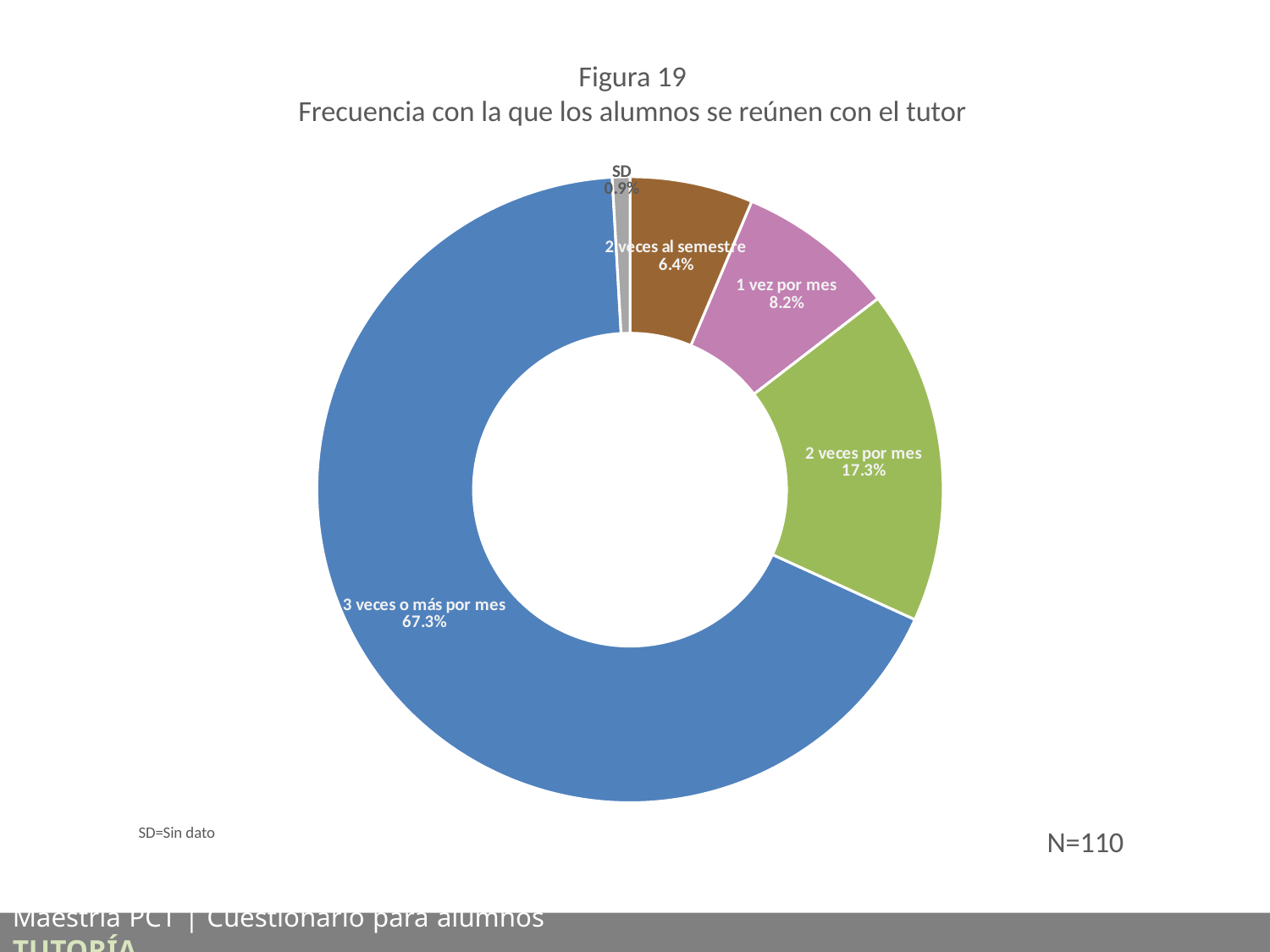
What kind of chart is shown on the slide? Pie chart (doughnut) What is the difference between the '2 veces por mes' and '1 vez por mes' shares? 9.1% Which is larger, the share for '1 vez por mes' or for '2 veces al semestre'? 1 vez por mes How many categories are shown in the chart? 5 What is the value for the '1 vez por mes' slice? 8.2% What is the value for the '2 veces al semestre' slice? 6.4% Which category has the largest share of the chart? 3 veces o más por mes What is the value for the '2 veces por mes' slice? 17.3% Which category has the smallest share of the chart? SD What percentage of students meet with their tutor 3 veces o más por mes? 67.3% What does 'SD' stand for according to the note on the slide? Sin dato What is the value for the 'SD' slice? 0.9%